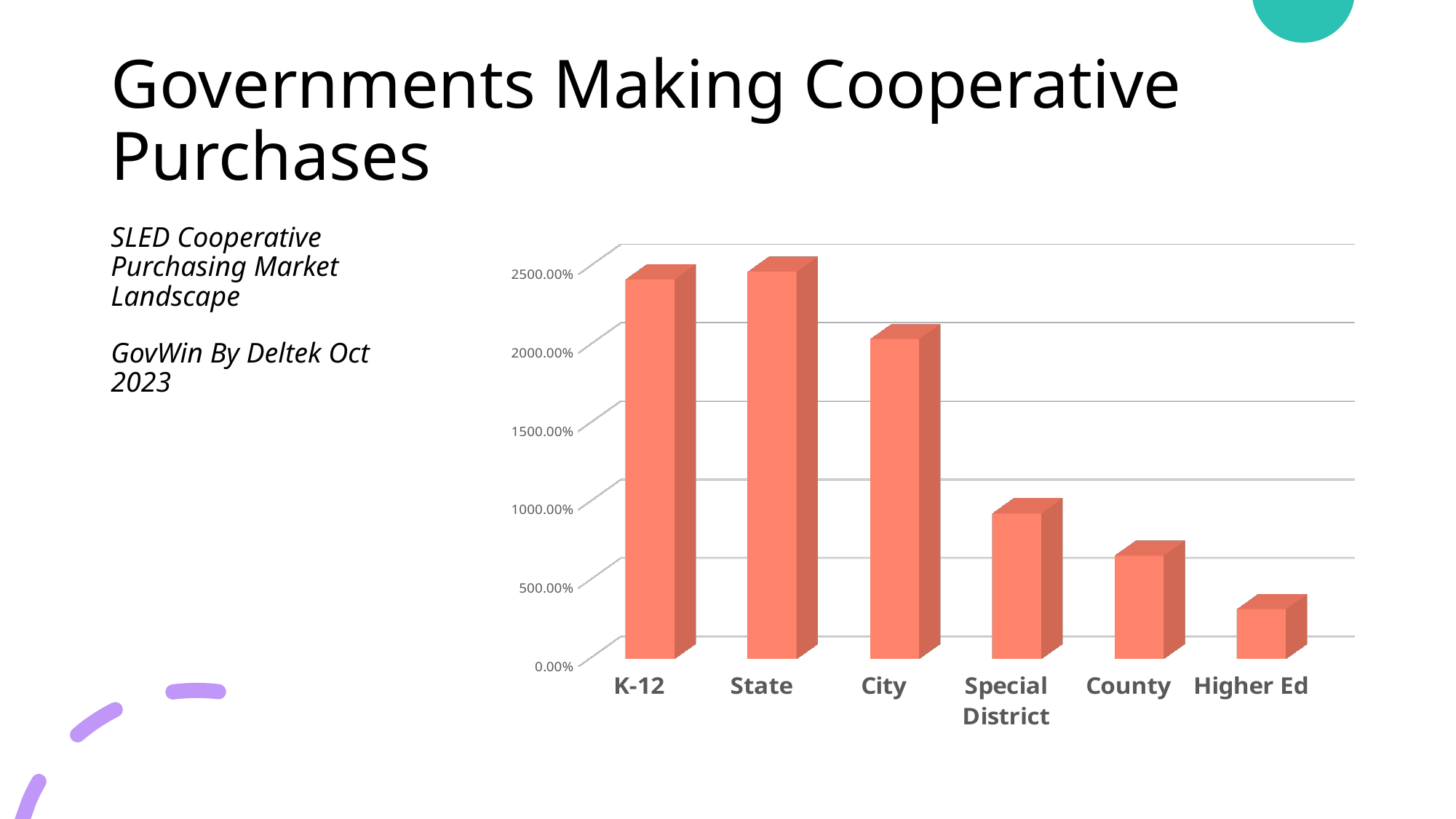
Is the value for K-12 greater or less than 2000.00%? greater Is the value for County greater or less than 1000.00%? less Is the value for City greater or less than 2500.00%? less What kind of chart is shown on the slide? Bar chart Which has a larger value, County or Higher Ed? County Which has a larger value, City or Special District? City How many categories are shown on the x axis of the chart? 6 Do the values generally rise or fall moving from left to right along the x axis? Fall Which category has the lowest value in the chart? Higher Ed What is the label of the category between City and County on the x axis? Special District